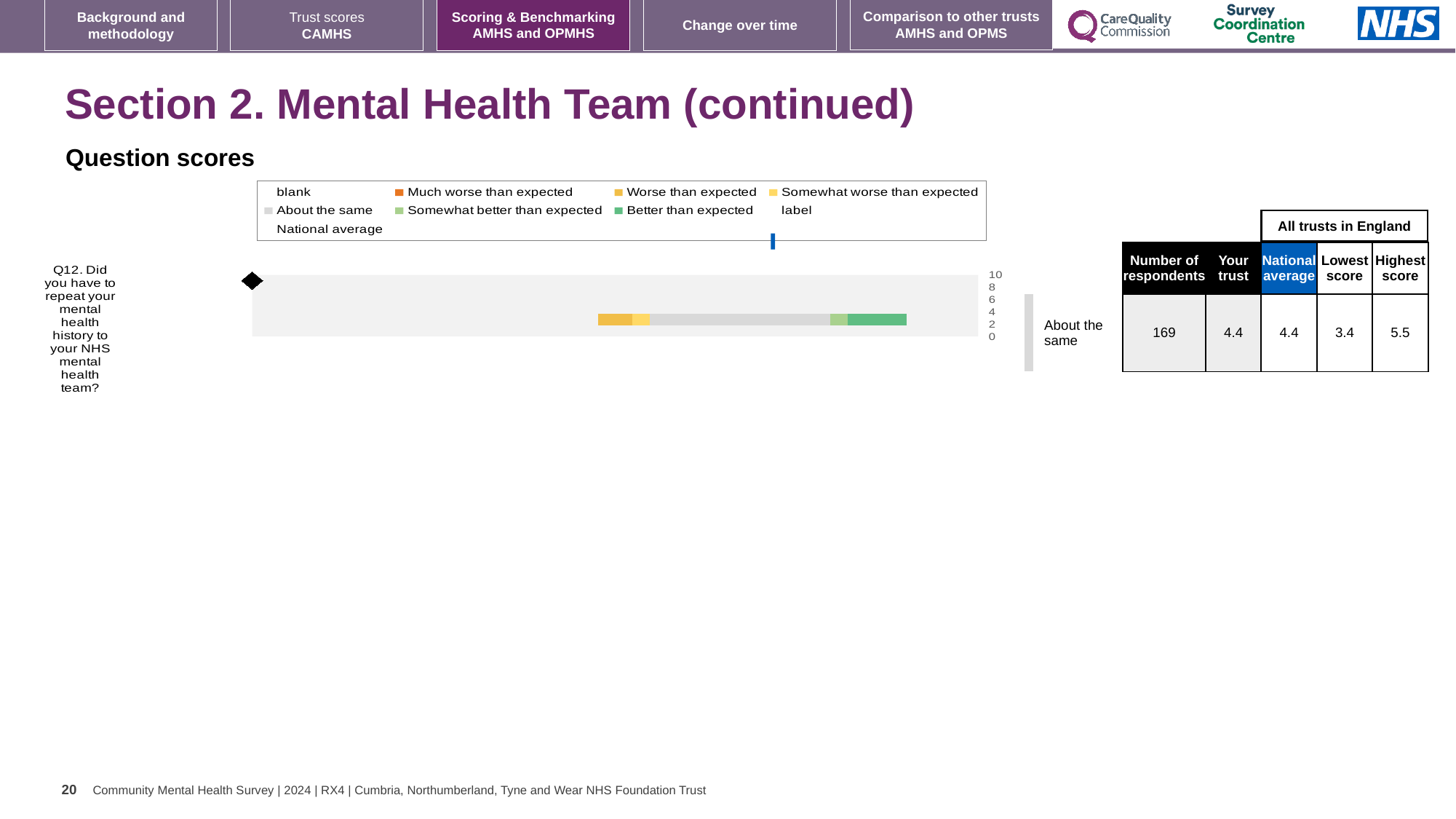
How many survey questions are plotted on the chart? 1 How many respondents answered Q12? 169 What is the 'Your trust' score for Q12? 4.4 Is the 'Your trust' score for Q12 greater or less than 4? greater Which question is plotted on the chart? Q12. Did you have to repeat your mental health history to your NHS mental health team? What is the national average score for Q12? 4.4 What is the lowest score among all trusts in England for Q12? 3.4 What benchmark category is shown for Q12? About the same What kind of chart is used to show the Q12 question score? bar chart What is the difference between the highest and lowest scores for Q12? 2.1 What is the highest score among all trusts in England for Q12? 5.5 What colour represents 'Better than expected' in the legend? green